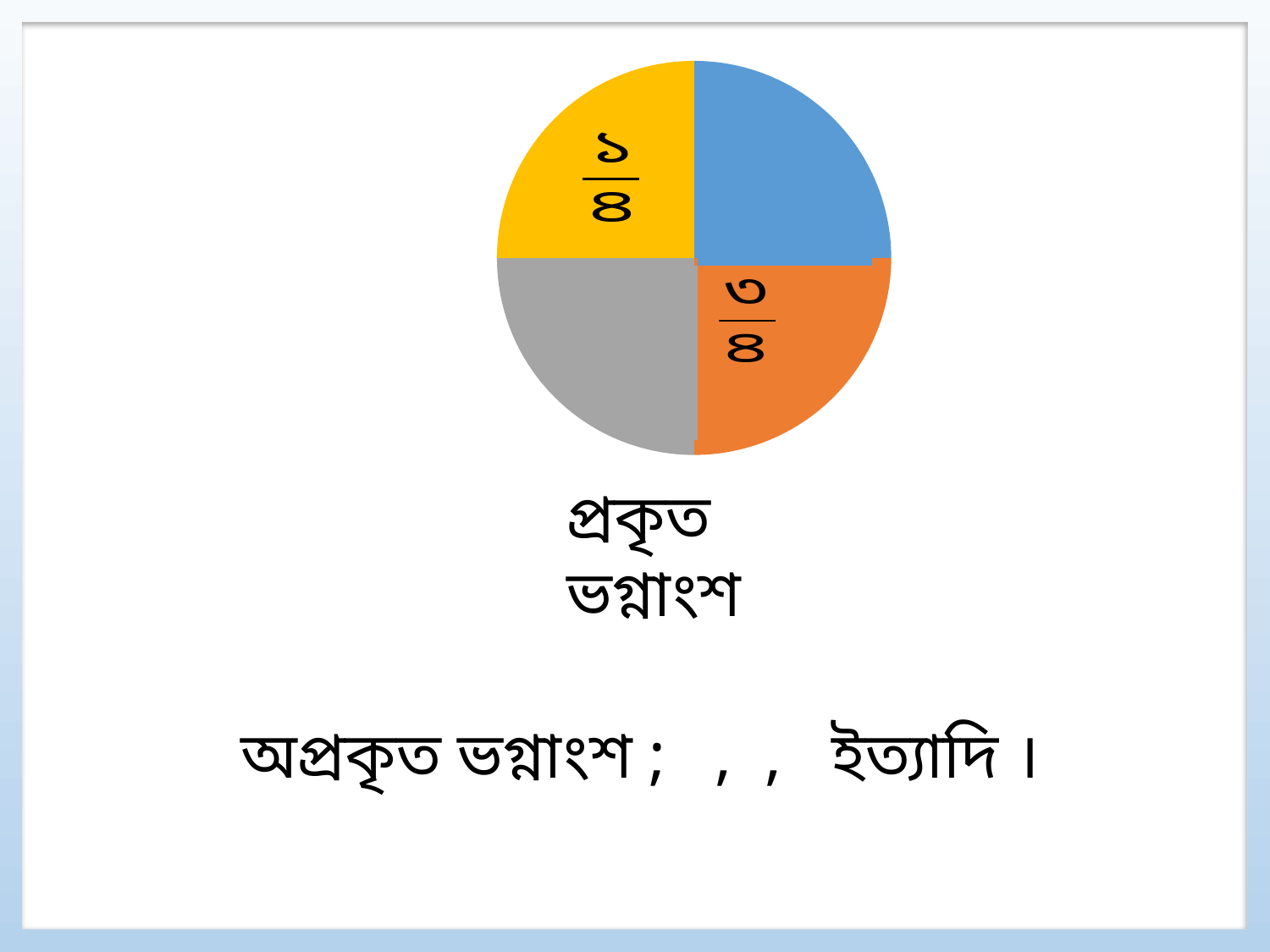
What kind of chart is shown on the slide? pie chart What label is printed on the yellow slice of the pie chart? ১/৪ What colour is the slice in the top-right quarter of the pie chart? blue What label is printed on the orange slice of the pie chart? ৩/৪ How many slices does the pie chart have? 4 What colour is the slice in the bottom-left quarter of the pie chart? gray What share of the pie does the yellow slice represent, according to its label? ১/৪